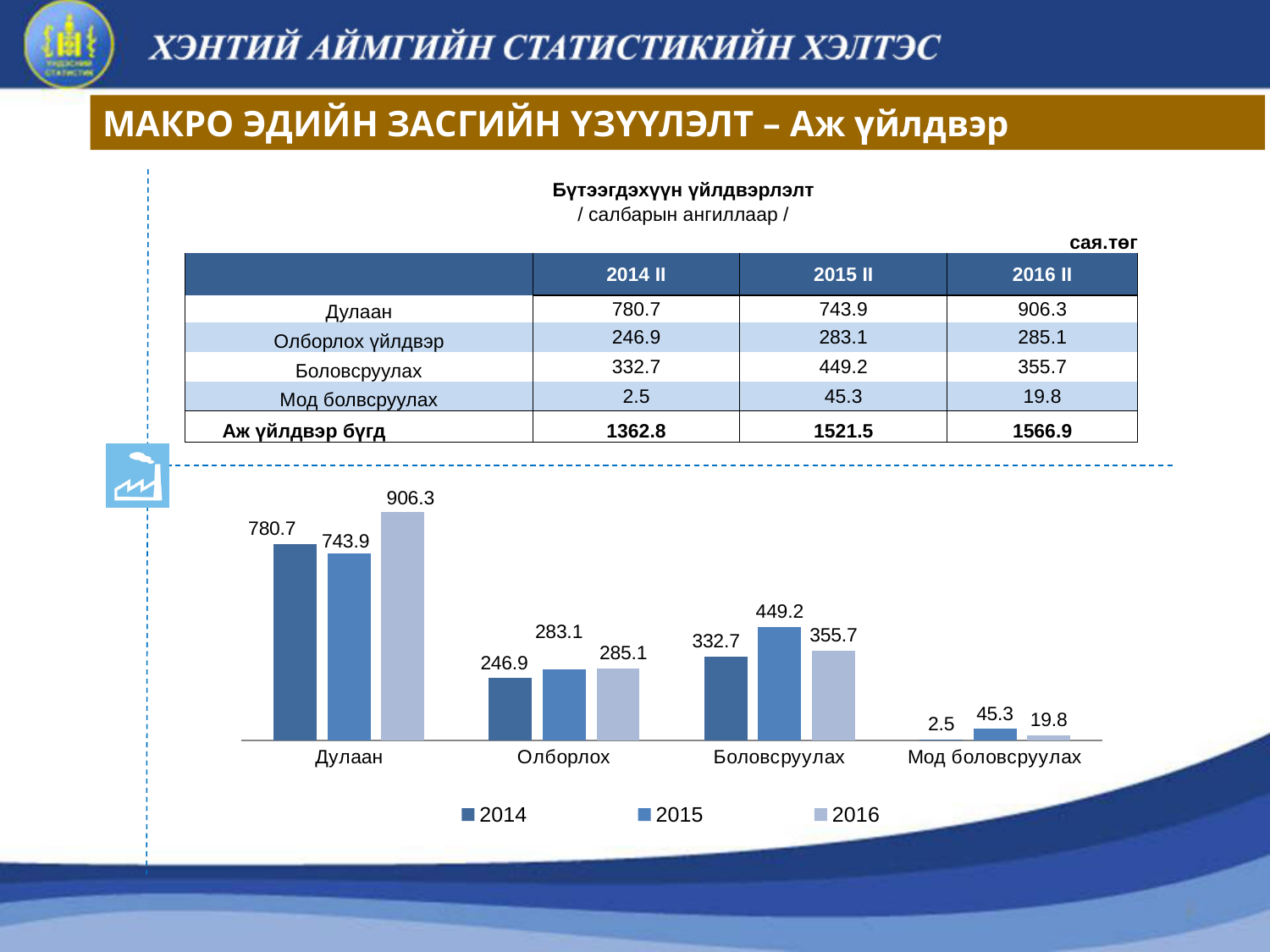
Which is larger for Боловсруулах: the 2015 value or the 2016 value? 2015 What is the value for Мод боловсруулах in the 2015 series? 45.3 Which category has the lowest value in the 2014 series? Мод боловсруулах How many series does the chart legend list? 3 What is the value for Олборлох in the 2014 series? 246.9 Do the values for Олборлох rise or fall from 2014 to 2016? rise Which category has the highest value in the 2015 series? Дулаан What is the value for Дулаан in the 2016 series? 906.3 What kind of chart is shown on the slide? bar chart What is the difference between the 2016 and 2015 values for Дулаан? 162.4 Which series is shown in the lightest colour in the chart legend? 2016 How many categories are shown on the x axis of the chart? 4